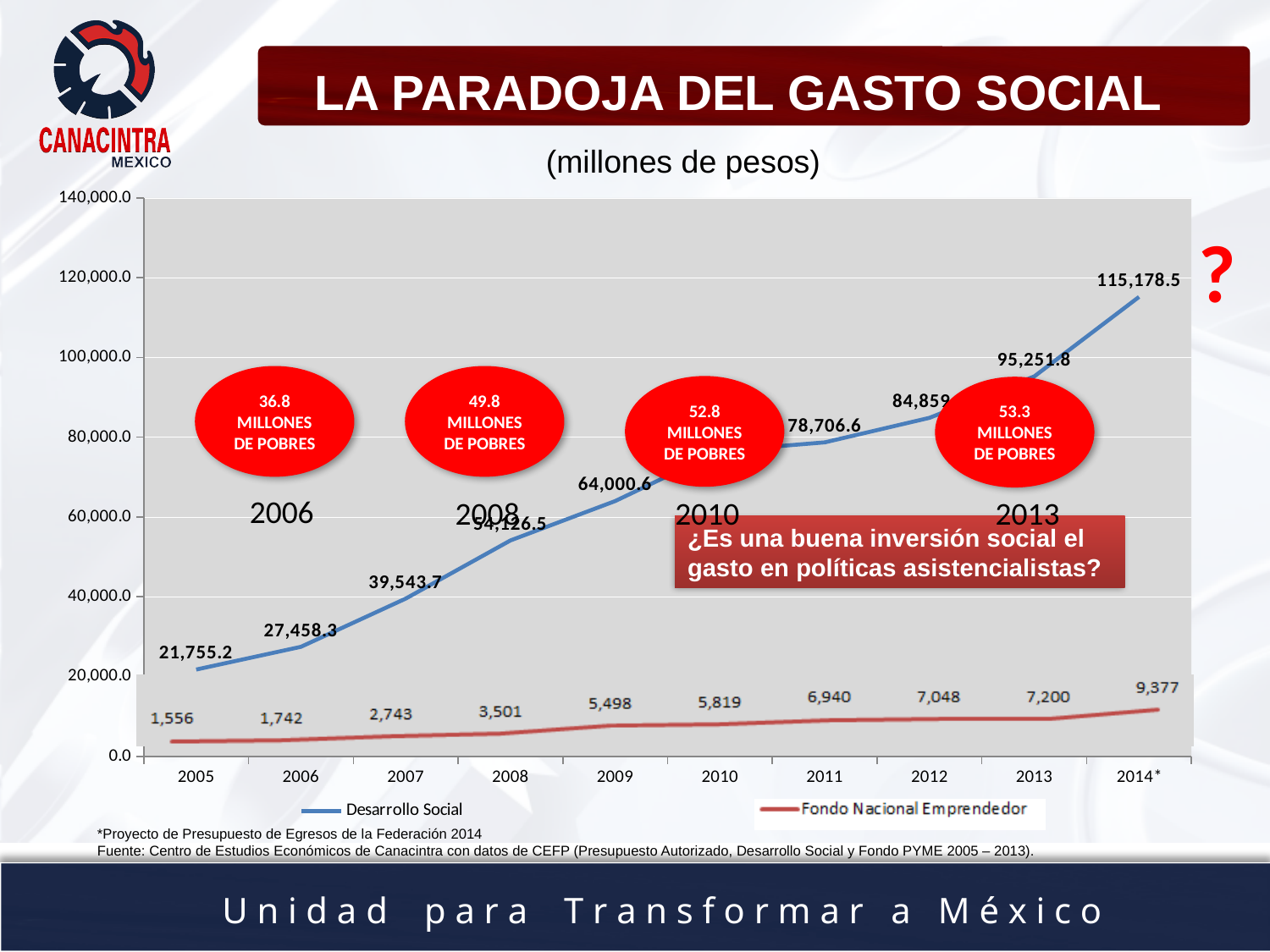
In which year is the Desarrollo Social series highest? 2014* What is the Fondo Nacional Emprendedor value for 2009? 5,498 What kind of chart is shown on the slide? Line chart What is the Desarrollo Social value for 2014*? 115,178.5 How many series does the legend list? 2 Which is larger, the Desarrollo Social value for 2007 or the Fondo Nacional Emprendedor value for 2007? Desarrollo Social What is the Desarrollo Social value for 2005? 21,755.2 In which year is the Fondo Nacional Emprendedor series lowest? 2005 What is the difference between the Desarrollo Social values for 2014* and 2013? 19,926.7 Is the Desarrollo Social value for 2010 greater or less than 60,000.0? greater What is the difference between the Fondo Nacional Emprendedor values for 2014* and 2005? 7,821 What is the Fondo Nacional Emprendedor value for 2013? 7,200